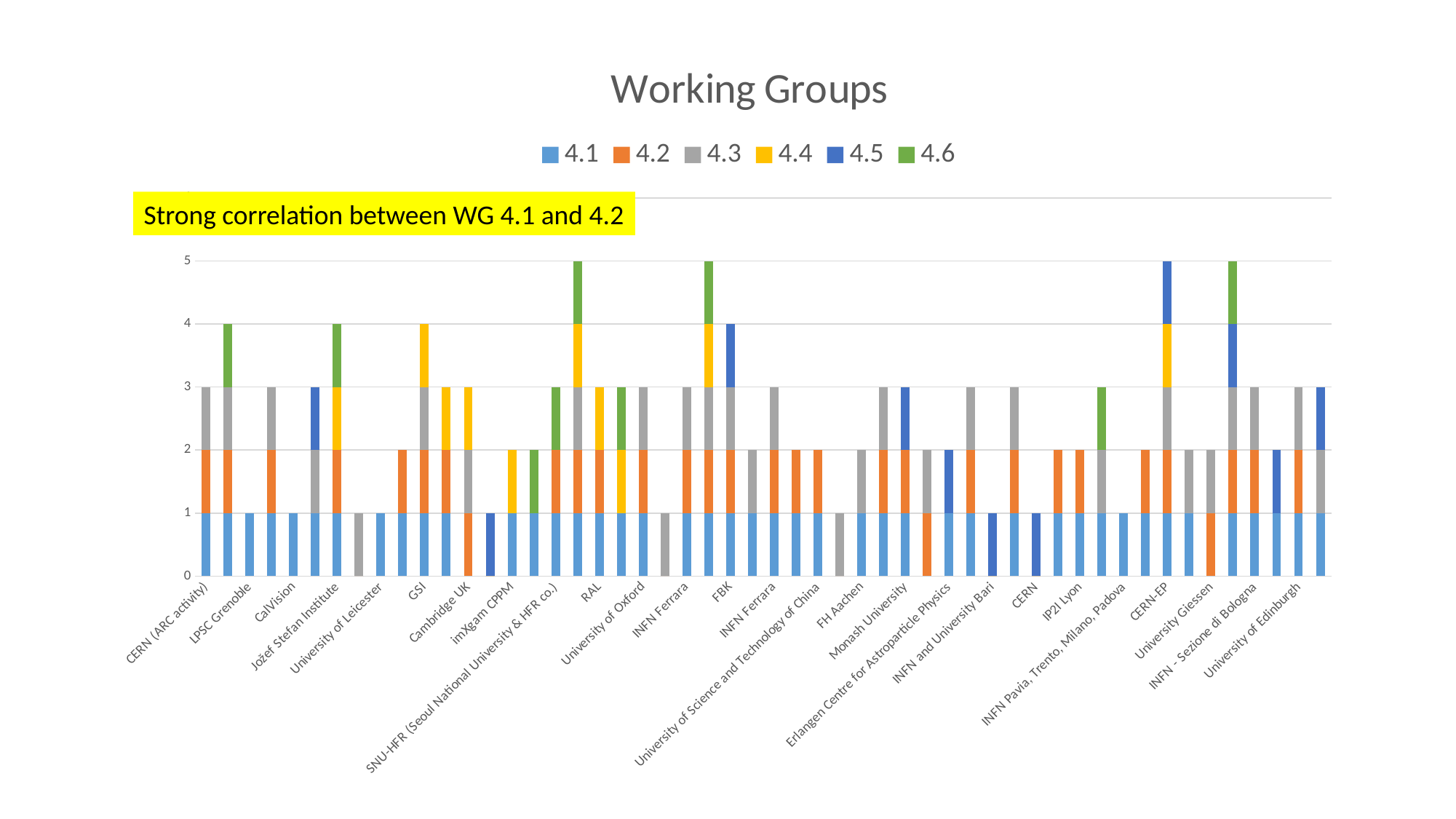
What is the total height of the stacked bar for RAL? 3 How many series does the legend list? 6 What is the total height of the stacked bar for CERN-EP? 5 Which has the taller stacked bar, CERN-EP or LPSC Grenoble? CERN-EP What is the title of the chart? Working Groups Is the total for CERN-EP greater or less than 4? greater What kind of chart is shown on the slide? Stacked bar chart Which series is shown in yellow in the legend? 4.4 What is the total height of the stacked bar for GSI? 4 Which has the taller stacked bar, GSI or University of Leicester? GSI Is the total for LPSC Grenoble greater or less than 2? less